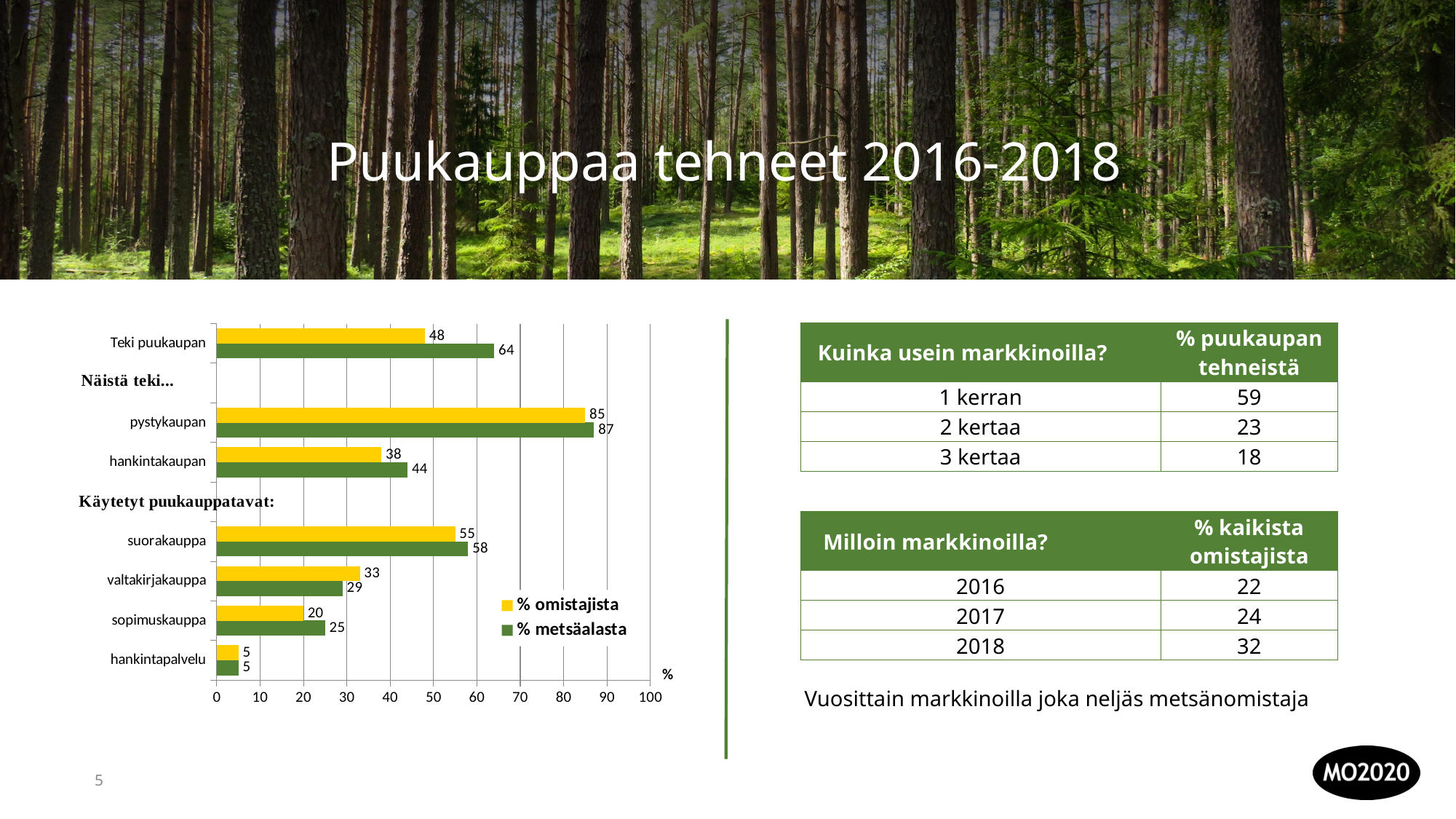
How many categories have bars plotted in the chart? 7 What kind of chart is shown on the slide? bar chart What is the value of % omistajista for sopimuskauppa? 20 Which is larger for valtakirjakauppa: % omistajista or % metsäalasta? % omistajista How many series does the legend list? 2 Which category has the highest % metsäalasta value? pystykaupan What is the value of % metsäalasta for hankintakaupan? 44 What is the difference between the % metsäalasta and % omistajista values for Teki puukaupan? 16 What is the value of % omistajista for Teki puukaupan? 48 What colour are the % omistajista bars? yellow What is the value of % metsäalasta for pystykaupan? 87 Which category has the lowest % omistajista value? hankintapalvelu